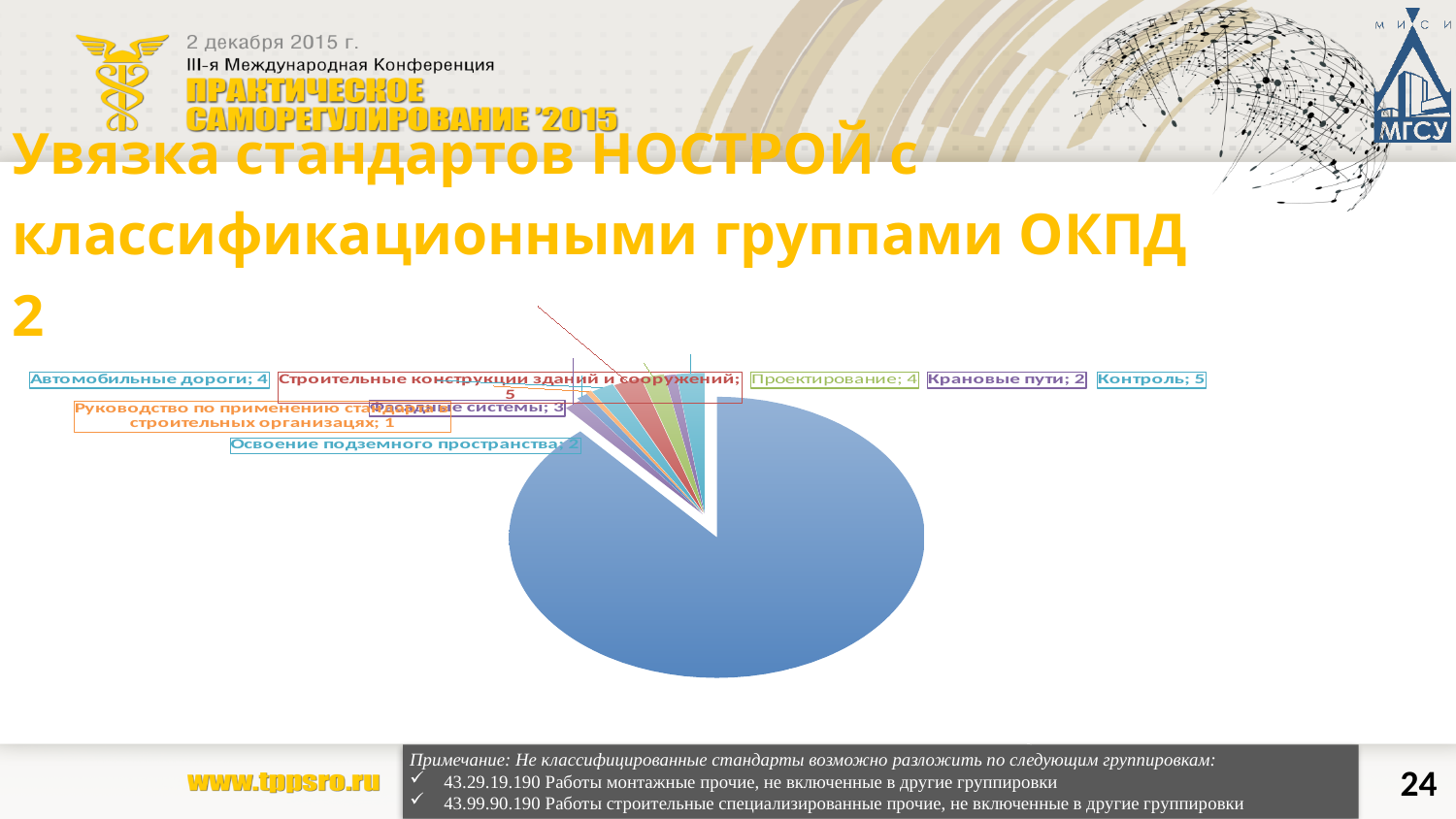
What is the value for Проектирование? 4 Which labelled category has the lowest value? Руководство по применению стандарта в строительных организацях What is the value for Освоение подземного пространства? 2 What is the value for Автомобильные дороги? 4 What is the value for Строительные конструкции зданий и сооружений? 5 What is the value for Контроль? 5 Which is larger, the value for Контроль or the value for Фасадные системы? Контроль What is the value for Фасадные системы? 3 What is the difference between the values for Автомобильные дороги and Освоение подземного пространства? 2 What is the value for Крановые пути? 2 What kind of chart is shown on the slide? pie chart What is the difference between the values for Строительные конструкции зданий и сооружений and Крановые пути? 3